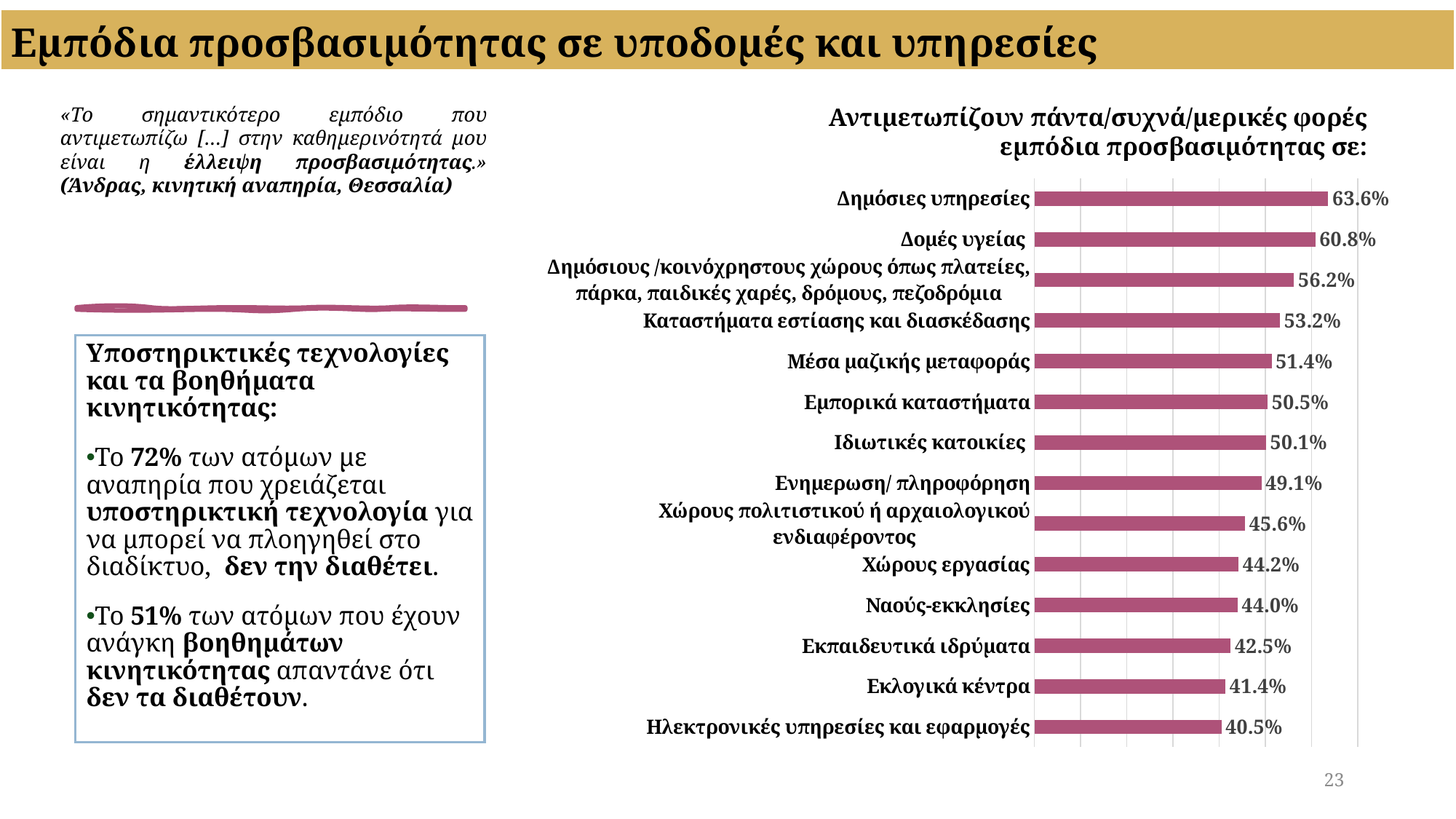
What is the value for Ναούς-εκκλησίες? 44.0% What is the difference between the values for Καταστήματα εστίασης και διασκέδασης and Εκλογικά κέντρα? 11.8% What is the value for Δημόσιες υπηρεσίες? 63.6% What is the value for Μέσα μαζικής μεταφοράς? 51.4% Which category has the lowest value? Ηλεκτρονικές υπηρεσίες και εφαρμογές What kind of chart is shown on the slide? bar chart What is the value for Εκπαιδευτικά ιδρύματα? 42.5% What is the title of the bar chart? Αντιμετωπίζουν πάντα/συχνά/μερικές φορές εμπόδια προσβασιμότητας σε: What is the difference between the values for Δημόσιες υπηρεσίες and Δομές υγείας? 2.8% How many categories does the bar chart show? 14 Which category has the highest value? Δημόσιες υπηρεσίες Which is larger, the value for Χώρους εργασίας or the value for Ενημέρωση/ πληροφόρηση? Ενημέρωση/ πληροφόρηση